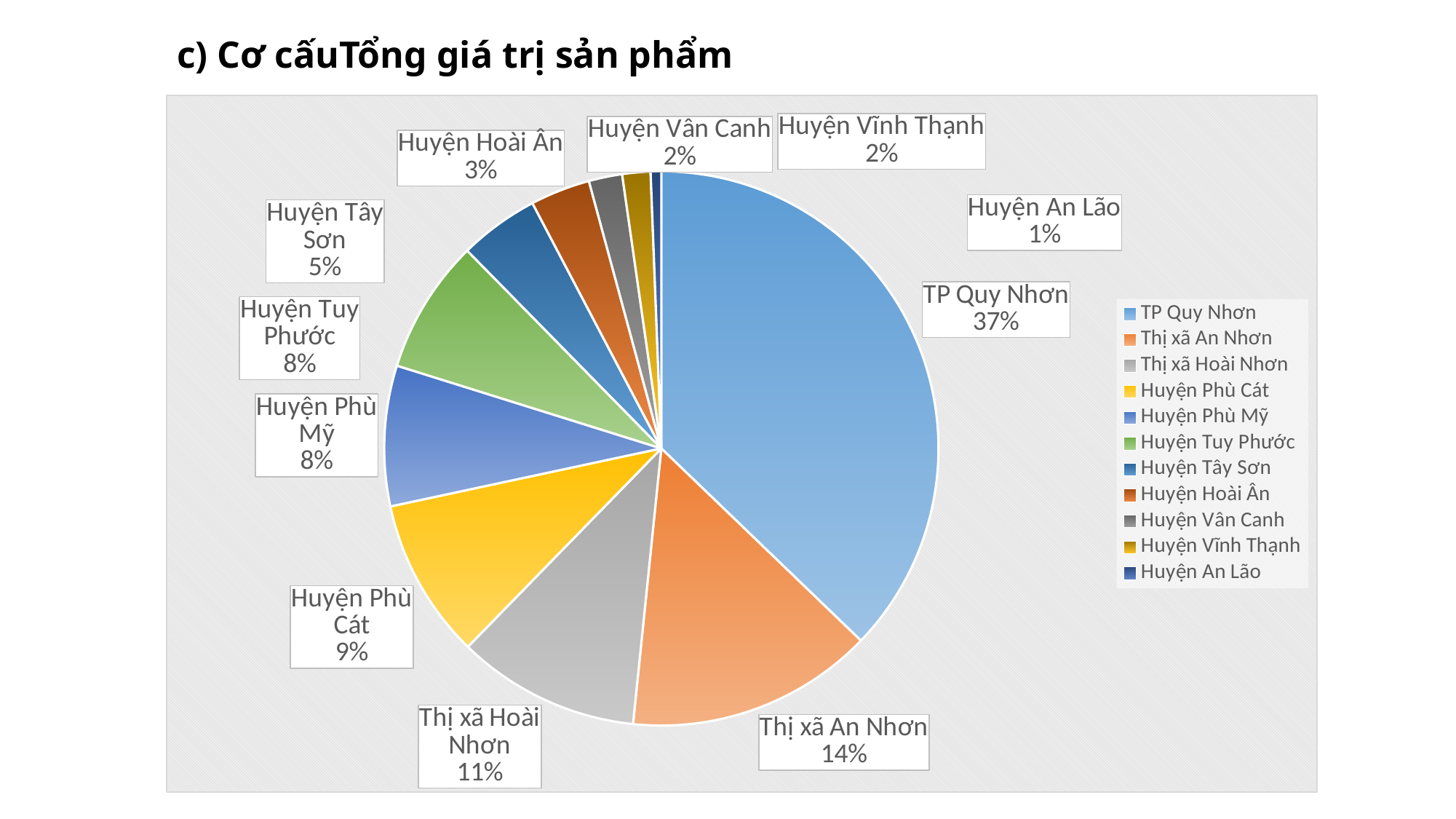
Which is larger, the share of Thị xã Hoài Nhơn or the share of Huyện Phù Mỹ? Thị xã Hoài Nhơn What is the value shown for Thị xã An Nhơn? 14% What share of the pie does TP Quy Nhơn hold? 37% Which category has the largest slice of the pie? TP Quy Nhơn Which category has the smallest slice of the pie? Huyện An Lão What is the difference between the shares of TP Quy Nhơn and Thị xã An Nhơn? 23% What is the value shown for Huyện Phù Cát? 9% How many entries does the legend list? 11 What is the title of the chart? c) Cơ cấuTổng giá trị sản phẩm What is the value shown for Huyện Tây Sơn? 5% How many slices does the pie chart have? 11 What type of chart is shown on the slide? pie chart